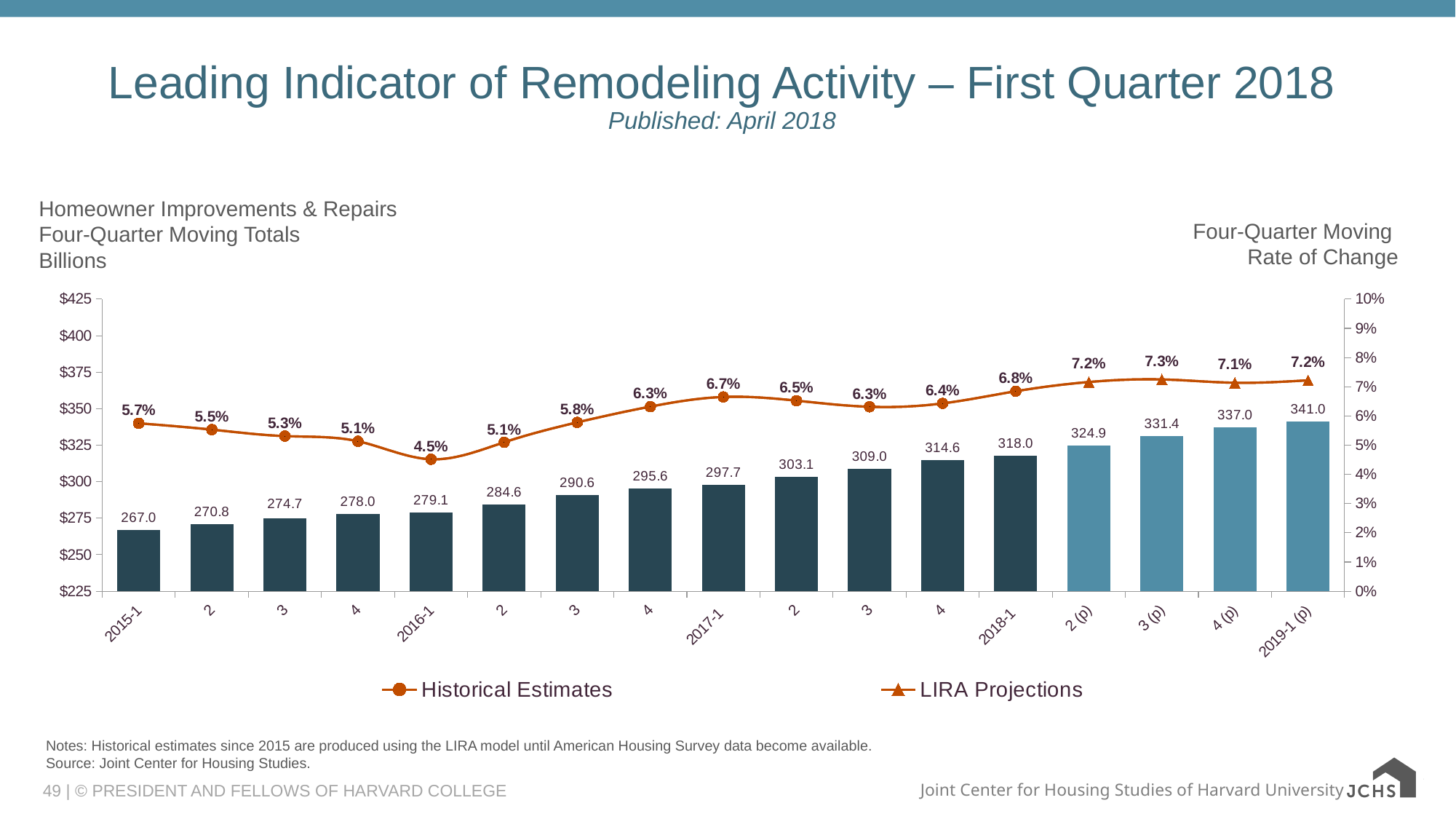
Which is larger, the rate of change for 2017-1 or for 2018-1? 2018-1 Which quarter has the highest four-quarter moving rate of change? 3 (p) (2018) How many quarters are shown on the x axis? 17 What is the projected four-quarter moving total for 2019-1 (p)? 341.0 What is the four-quarter moving total (in billions) for 2018-1? 318.0 What is the difference in the rate of change between 2017-1 and 2016-1? 2.2 percentage points Do the four-quarter moving totals rise or fall from 2015-1 to 2019-1 (p)? rise Which quarter has the lowest four-quarter moving total? 2015-1 Which quarter has the lowest four-quarter moving rate of change? 2016-1 What is the difference between the four-quarter moving totals for 2019-1 (p) and 2015-1? 74.0 What is the four-quarter moving rate of change shown for 2016-1? 4.5% How many series does the legend list? 2